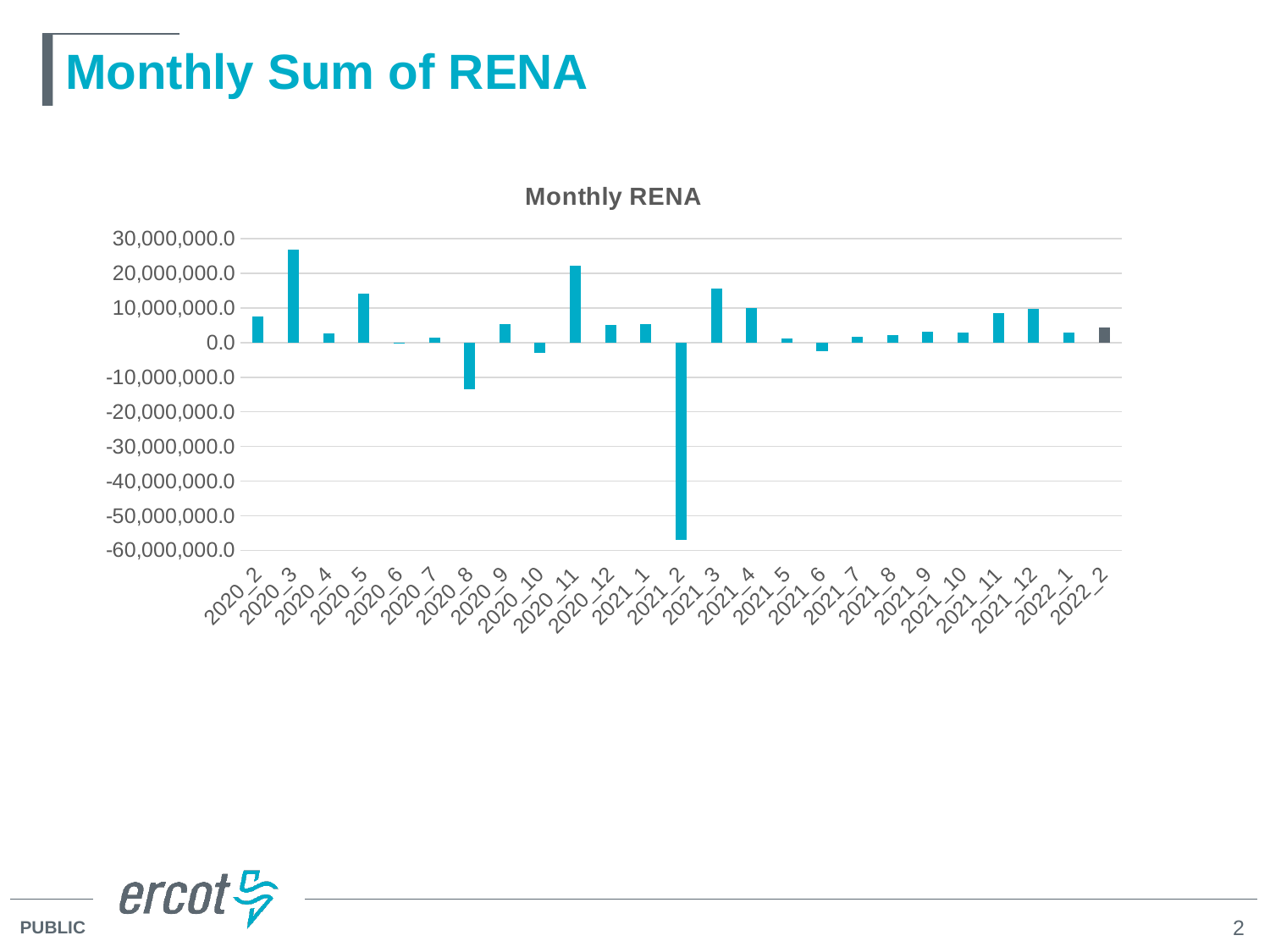
Is the value for 2020_3 greater or less than 20,000,000.0? greater Which bar is drawn in a different colour (dark grey) from the rest? 2022_2 Which is larger, the value for 2020_2 or the value for 2020_4? 2020_2 How many months (categories) are plotted on the x axis? 25 Is the value for 2021_3 greater or less than 10,000,000.0? greater Which month has the highest Monthly RENA value? 2020_3 Is the value for 2021_2 greater or less than -50,000,000.0? less Which month has the lowest Monthly RENA value? 2021_2 What kind of chart is shown on the slide? Bar chart What is the title of the chart? Monthly RENA Which is larger, the value for 2020_3 or the value for 2020_11? 2020_3